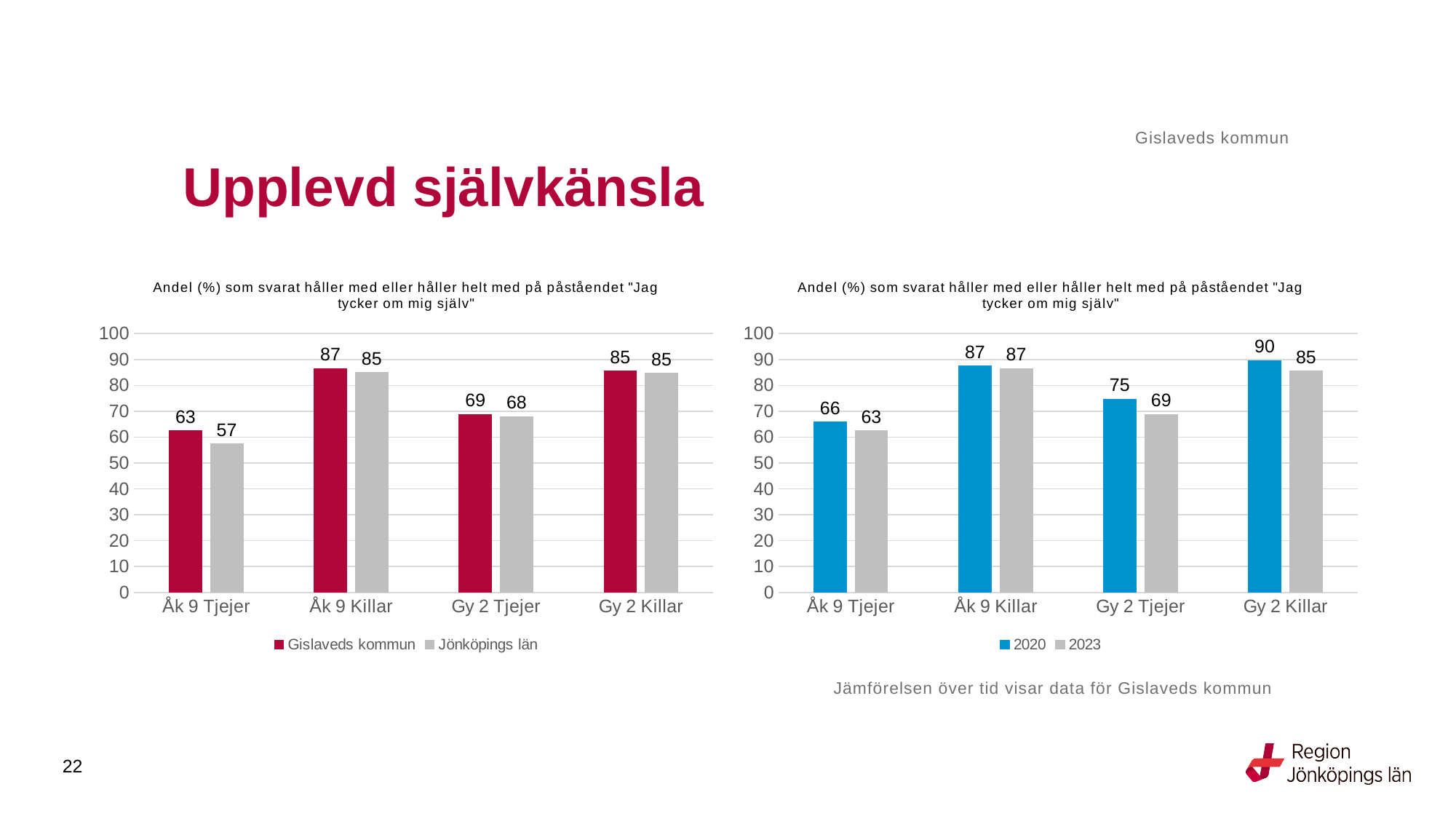
How many categories are shown on the x axis of the right chart? 4 In the right chart, what is the value for 2020 for Gy 2 Killar? 90 In the right chart, which category has the lowest value for 2023? Åk 9 Tjejer In the left chart, what is the difference between Gislaveds kommun and Jönköpings län for Åk 9 Tjejer? 6 In the left chart, which category has the highest value for Gislaveds kommun? Åk 9 Killar In the left chart, what is the value for Gislaveds kommun for Åk 9 Tjejer? 63 In the right chart, what is the value for 2023 for Gy 2 Tjejer? 69 What kind of chart is the left chart? Bar chart In the right chart, which is larger for Gy 2 Killar: 2020 or 2023? 2020 In the right chart, what is the difference between 2020 and 2023 for Gy 2 Tjejer? 6 In the left chart, how many series does the legend list? 2 In the left chart, what is the value for Jönköpings län for Åk 9 Tjejer? 57